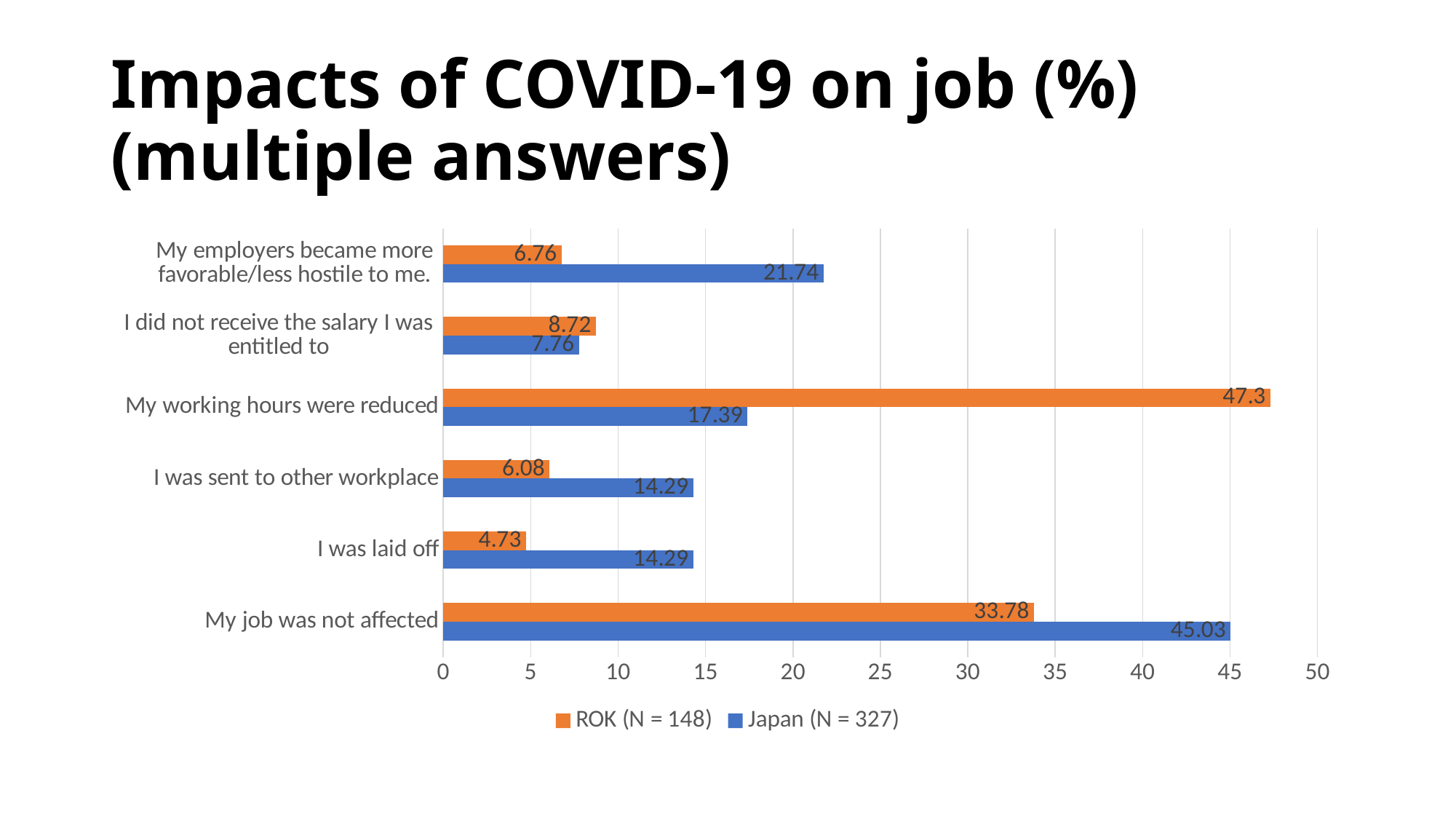
What is the Japan (N = 327) value for "My employers became more favorable/less hostile to me."? 21.74 What kind of chart is shown on the slide? Bar chart How many categories are shown on the chart? 6 Which category has the lowest Japan (N = 327) value? I did not receive the salary I was entitled to What is the Japan (N = 327) value for "My job was not affected"? 45.03 For "I was sent to other workplace", which series has the larger value, ROK (N = 148) or Japan (N = 327)? Japan (N = 327) How many series does the legend list? 2 What is the ROK (N = 148) value for "My working hours were reduced"? 47.3 Which category has the highest ROK (N = 148) value? My working hours were reduced Is the ROK (N = 148) value for "My working hours were reduced" greater or less than 45? greater What is the difference between the Japan (N = 327) and ROK (N = 148) values for "My job was not affected"? 11.25 What is the ROK (N = 148) value for "I was laid off"? 4.73